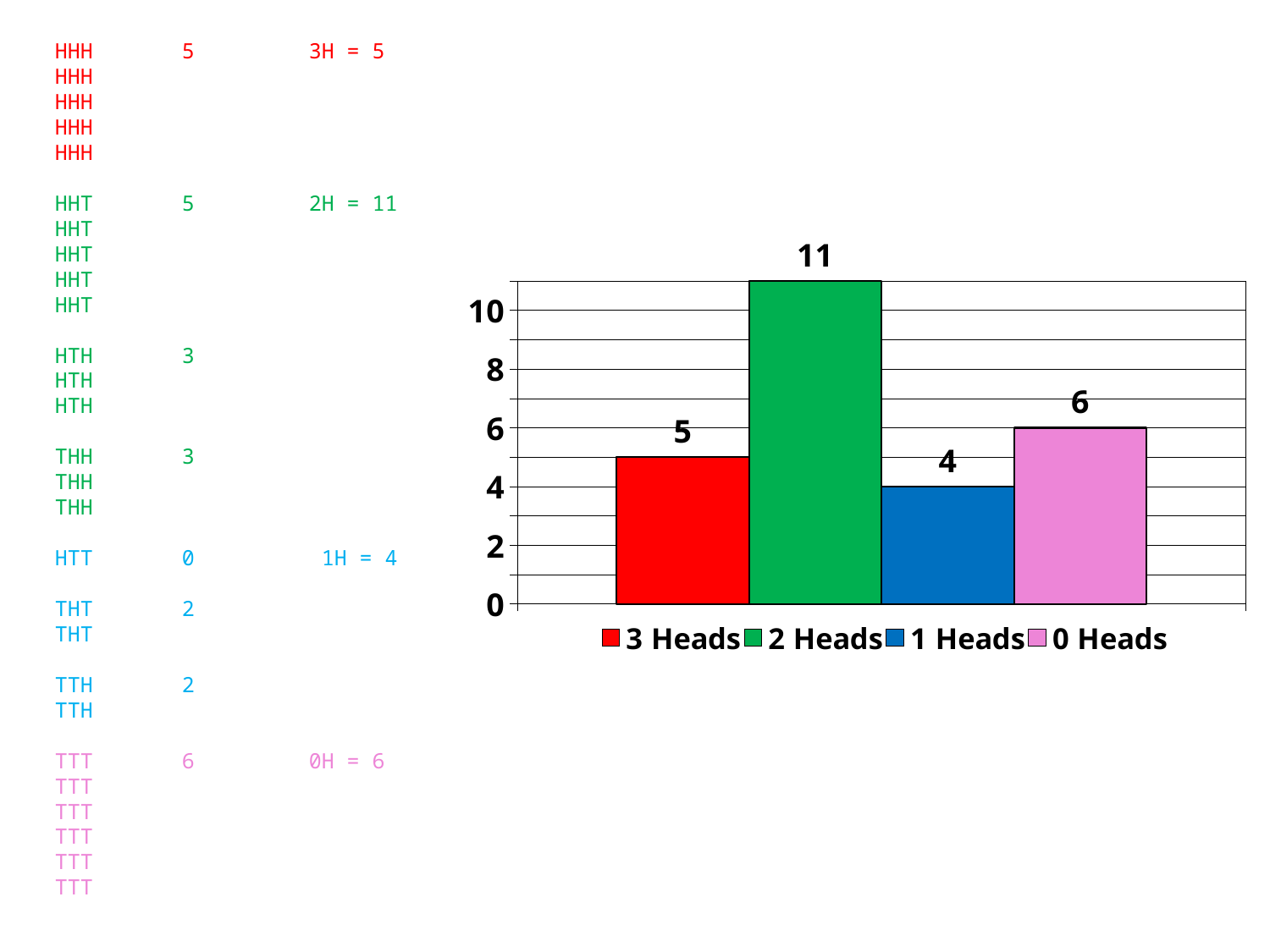
Which category has the lowest value? 1 Heads What is the value for 1 Heads? 4 What is the difference between the values for 2 Heads and 3 Heads? 6 Which category has the highest value? 2 Heads What kind of chart is shown? bar chart What is the difference between the values for 0 Heads and 1 Heads? 2 What is the value for 2 Heads? 11 What colour is the bar for 0 Heads? pink Which is larger, the value for 0 Heads or the value for 3 Heads? 0 Heads How many series does the legend list? 4 What is the value for 0 Heads? 6 What is the value for 3 Heads? 5